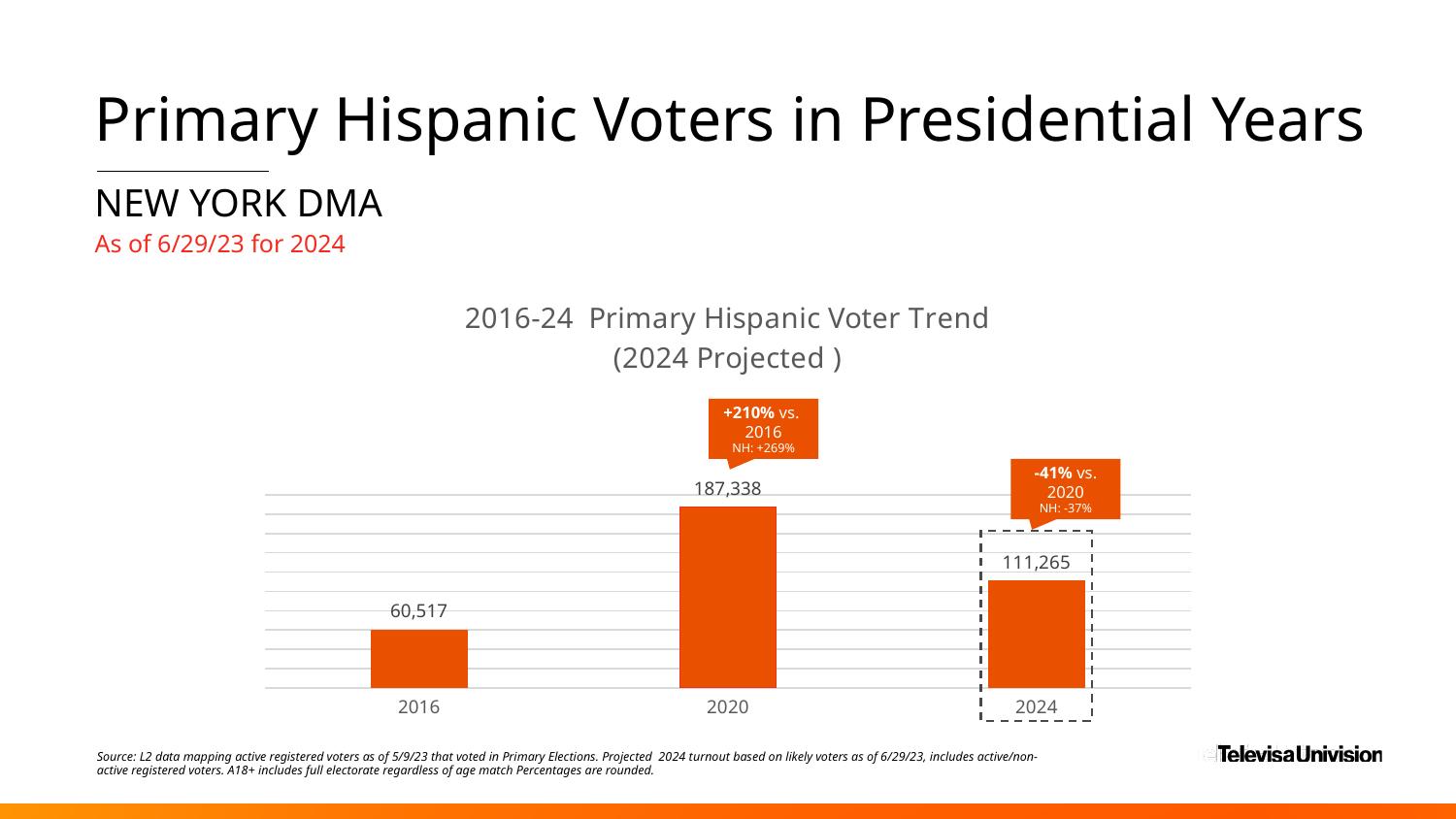
What kind of chart is this? Bar chart What is the title of the chart? 2016-24 Primary Hispanic Voter Trend (2024 Projected ) How many years are shown on the chart? 3 Which is larger, the value for 2024 or the value for 2016? 2024 What is the projected value for 2024? 111,265 Which year has the lowest value? 2016 Which year has the highest value? 2020 What is the difference between the 2020 and 2016 values? 126,821 What is the value for 2020? 187,338 What is the difference between the 2020 and 2024 values? 76,073 What percentage change vs. 2016 is shown in the callout above the 2020 bar? +210% What is the value for 2016? 60,517